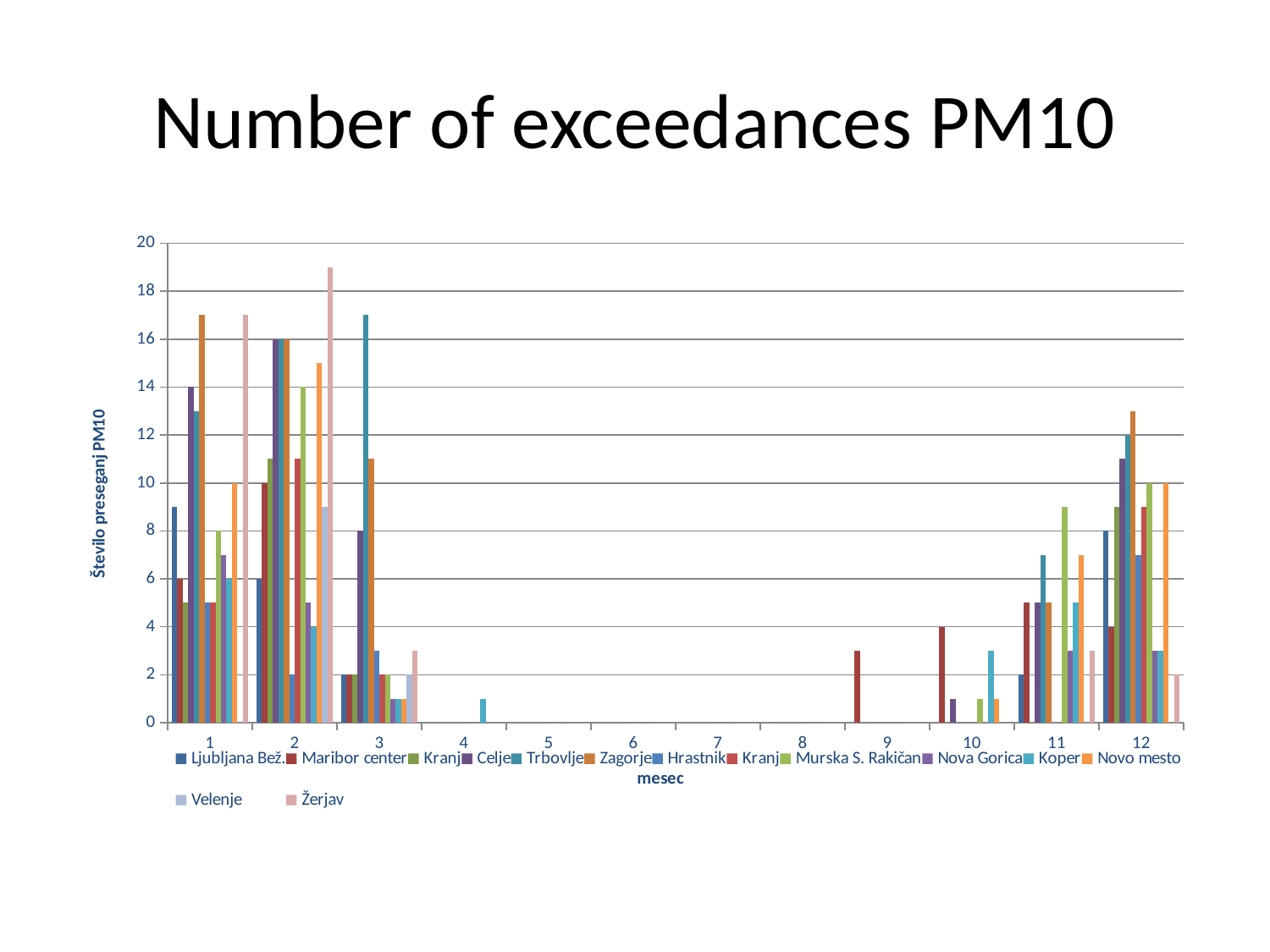
Is the tallest bar in month 3 greater or less than 16? greater How many months show no bars at all? 4 What kind of chart is shown on the slide? bar chart Is the tallest bar in month 2 greater or less than 18? greater Is the tallest bar in month 9 greater or less than 4? less How many series does the legend list? 14 What is the label of the vertical axis? Število preseganj PM10 How many months (categories) are shown on the x axis? 12 Which month contains the tallest bar in the whole chart? 2 What is the title of the chart? Number of exceedances PM10